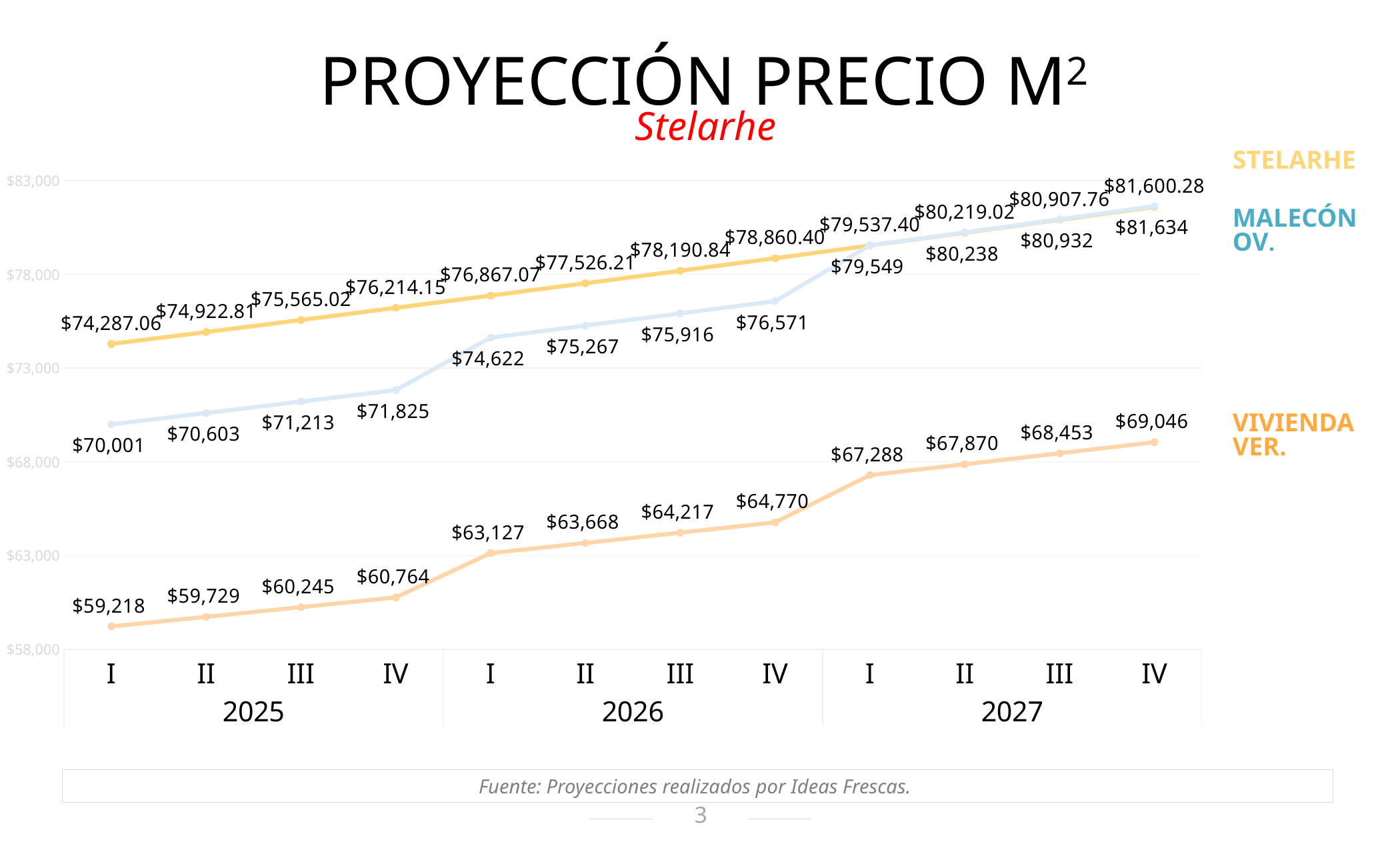
Is the MALECÓN OV. value for quarter I of 2026 greater or less than $73,000? greater What is the VIVIENDA VER. value for quarter I of 2026? $63,127 What kind of chart is shown on the slide? line chart What is the STELARHE value for quarter I of 2025? $74,287.06 How many series does the chart show? 3 Does the VIVIENDA VER. line rise or fall from 2025 to 2027? rise What is the STELARHE value for quarter IV of 2027? $81,600.28 Which series has the highest value in quarter IV of 2025? STELARHE What is the difference between the VIVIENDA VER. values for quarter IV of 2027 and quarter I of 2025? $9,828 Which series has the lowest value in quarter I of 2025? VIVIENDA VER. How many quarterly data points does each line have? 12 What is the MALECÓN OV. value for quarter IV of 2027? $81,634